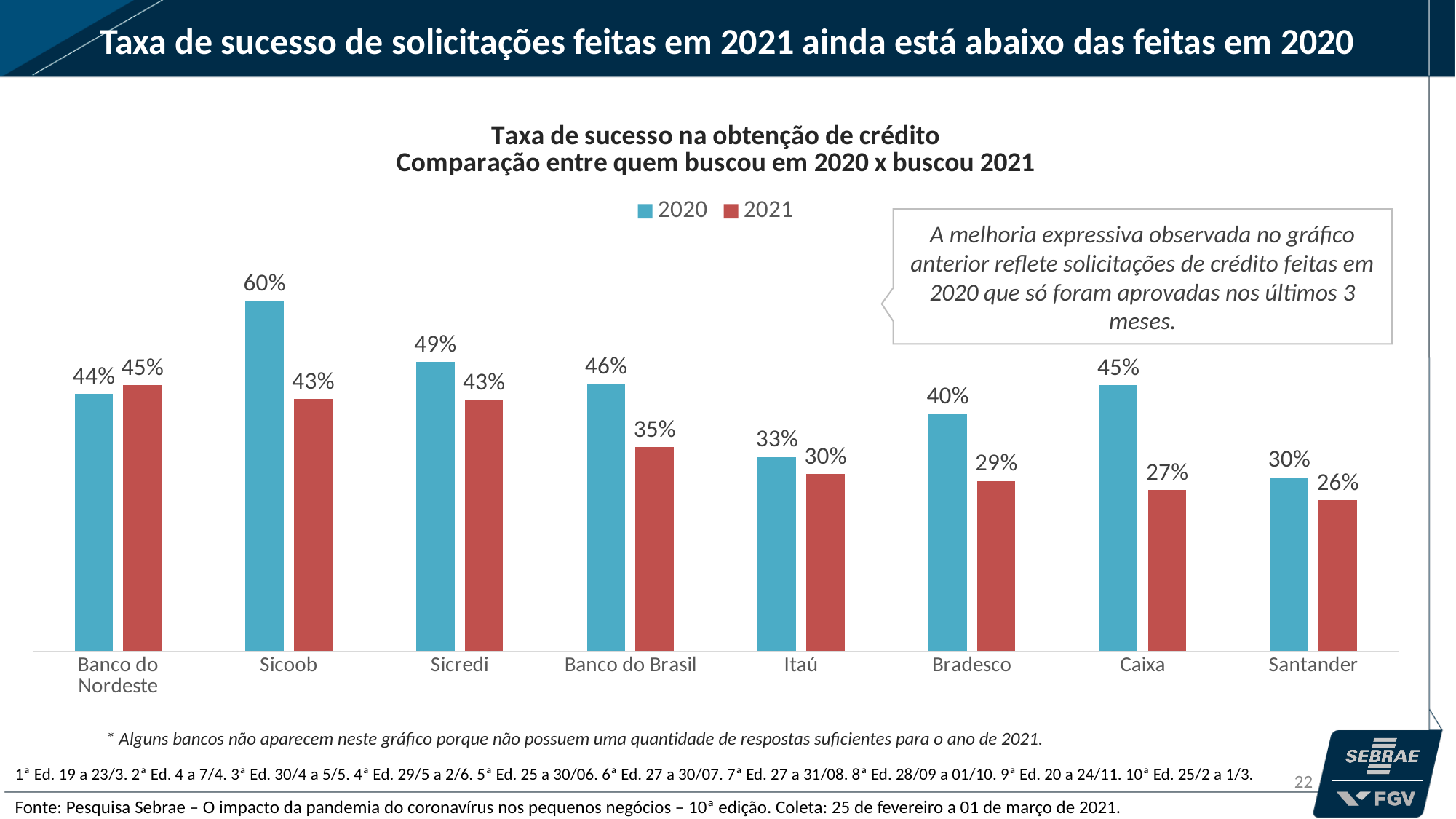
How many series does the legend list? 2 Which colour represents the 2021 series? Red Which bank has the lowest 2021 value? Santander What is the 2020 value for Sicoob? 60% What kind of chart is shown? Bar chart What is the difference between the 2020 and 2021 values for Sicoob? 17% What is the difference between the 2020 and 2021 values for Caixa? 18% How many banks are shown on the x axis? 8 Which bank has the highest 2020 value? Sicoob What is the 2021 value for Banco do Brasil? 35% Which is larger for Banco do Nordeste, the 2020 value or the 2021 value? 2021 What is the 2021 value for Santander? 26%